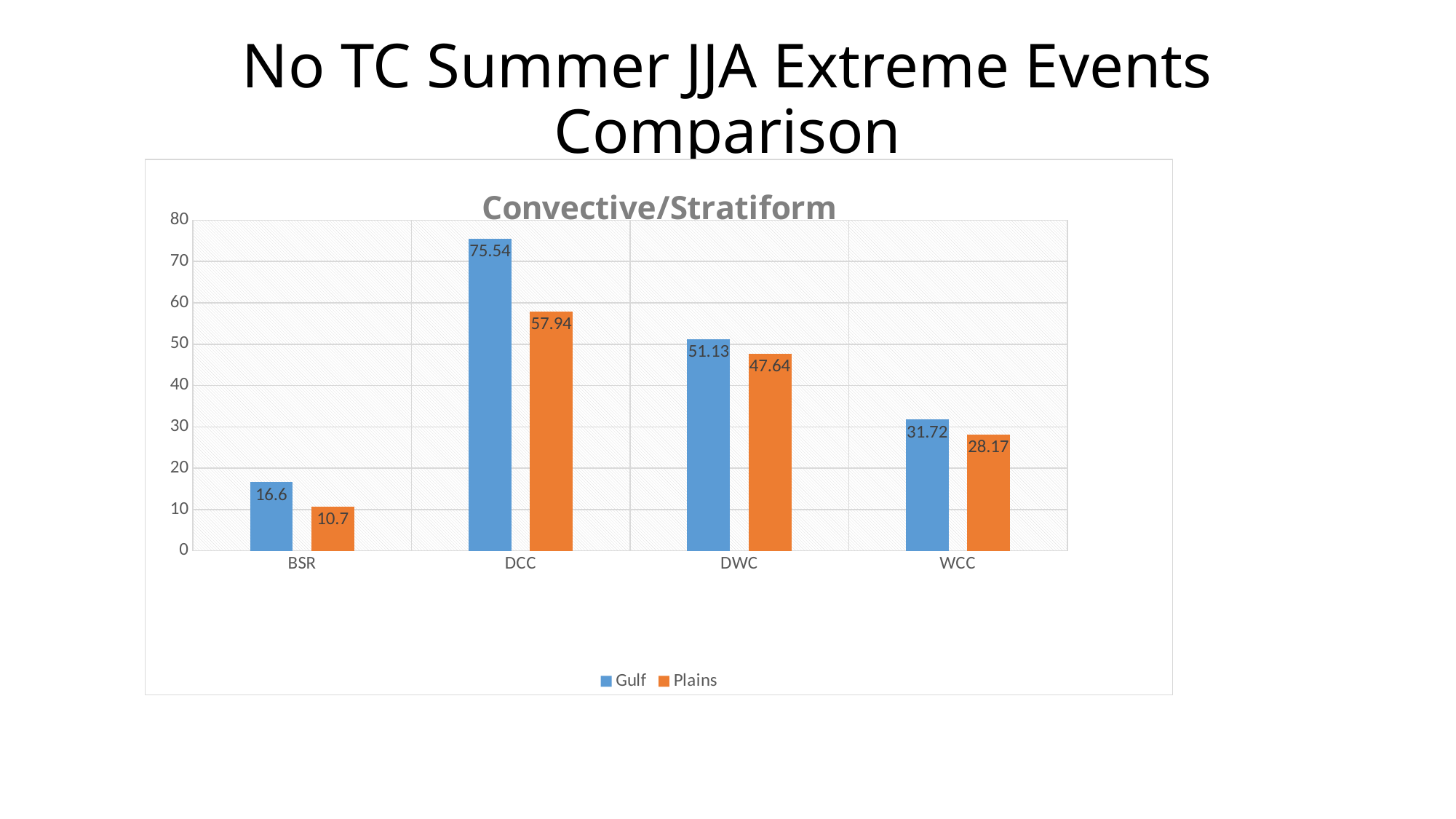
What is the title of the chart? Convective/Stratiform Which category has the lowest Plains value? BSR Which is larger for WCC, the Gulf value or the Plains value? Gulf What kind of chart is shown? Bar chart What is the Plains value for DWC? 47.64 How many categories are shown on the x axis? 4 What is the Plains value for BSR? 10.7 What is the difference between the Gulf and Plains values for DCC? 17.6 What is the Gulf value for WCC? 31.72 How many series does the legend list? 2 Which category has the highest Gulf value? DCC What is the Gulf value for DCC? 75.54